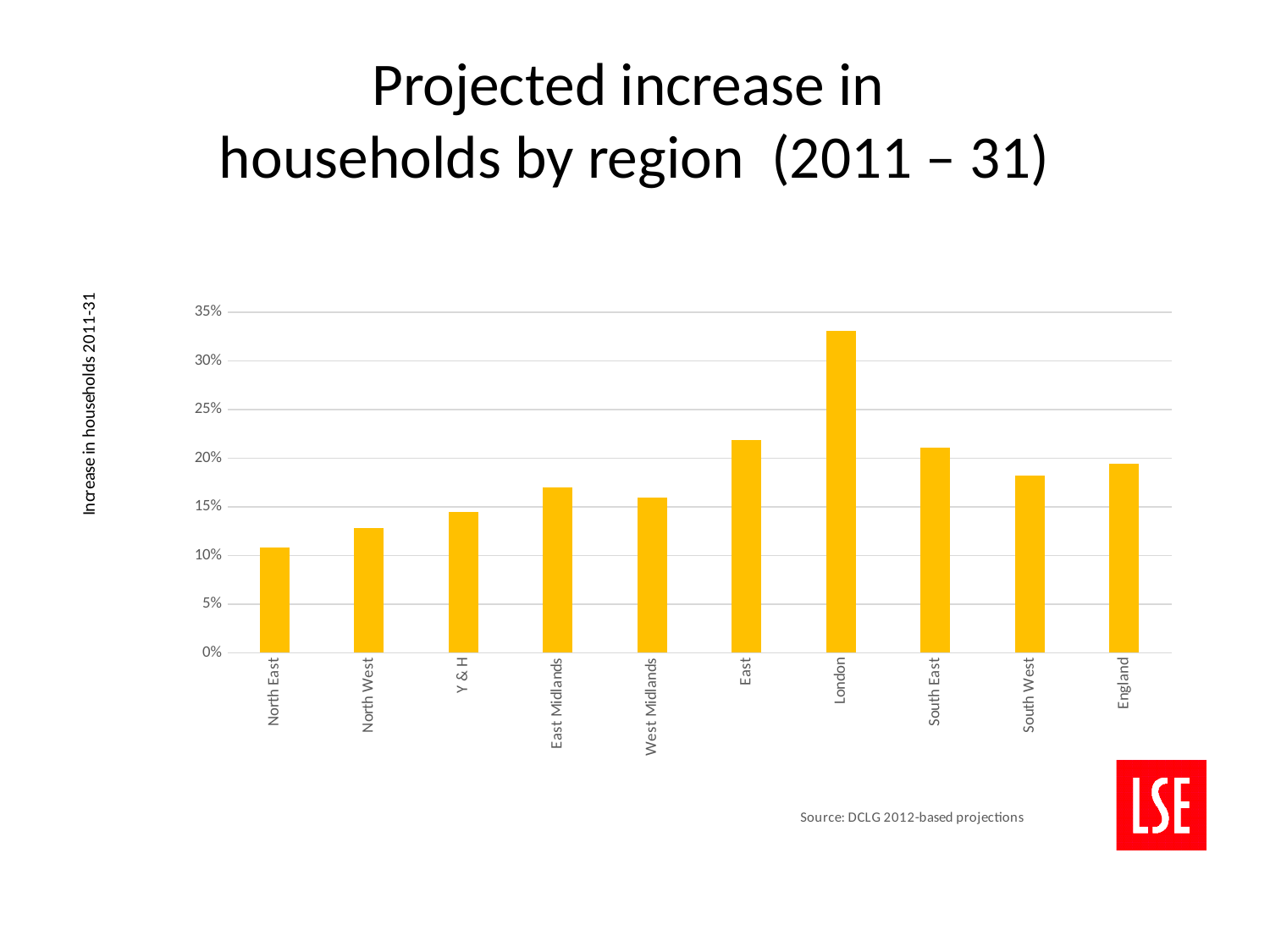
How many categories are plotted on the x axis? 10 Which region has the lowest projected increase in households? North East What kind of chart is shown on the slide? bar chart Is the value for East greater or less than 20%? greater Which is larger, the value for North West or the value for East Midlands? East Midlands What is the title of the chart? Projected increase in households by region (2011 – 31) What is the label on the vertical axis? Increase in households 2011-31 Which is larger, the value for East or the value for South West? East Is the value for North East greater or less than 15%? less Is the value for West Midlands greater or less than 20%? less Which region has the highest projected increase in households? London